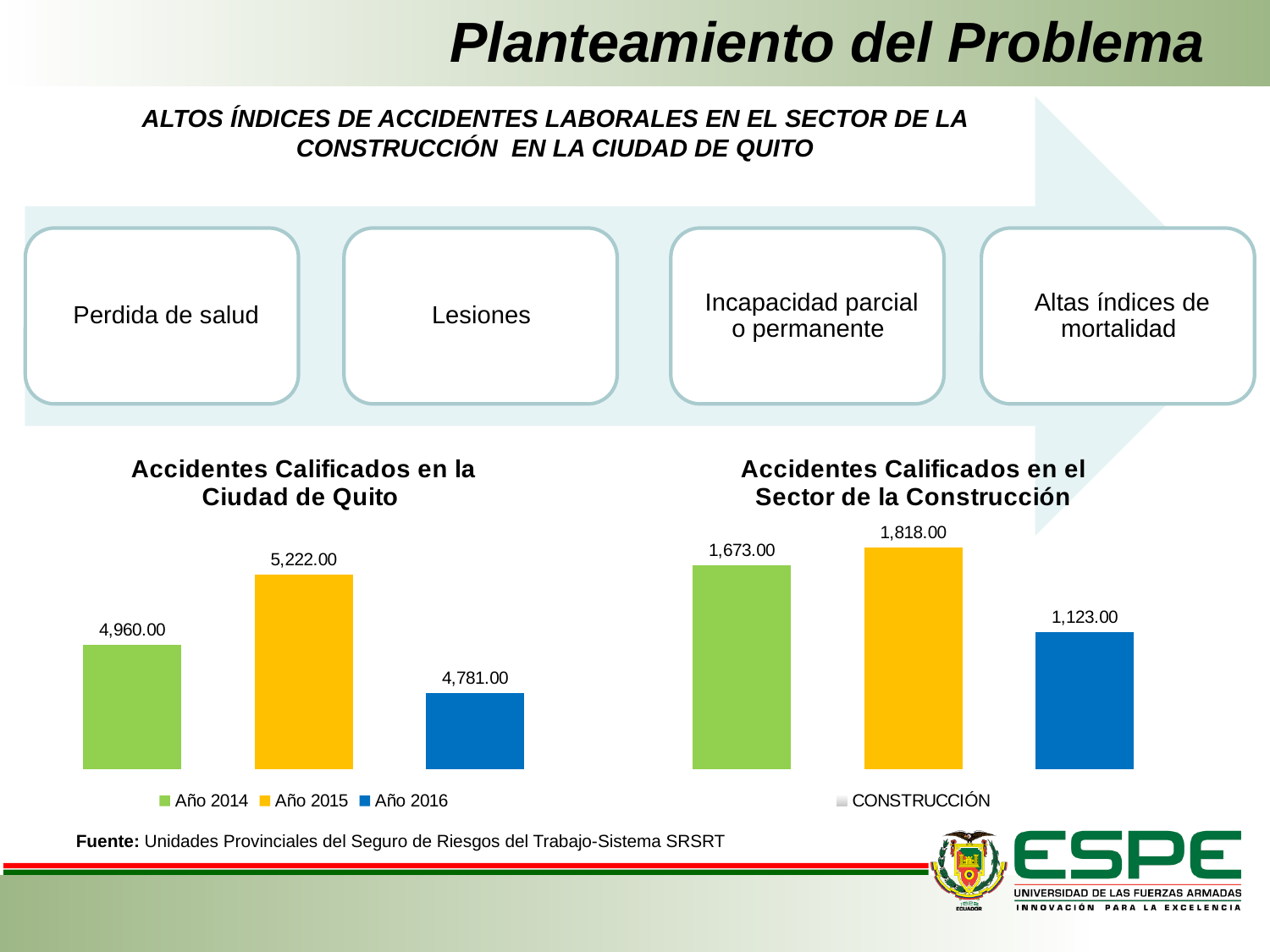
In the chart 'Accidentes Calificados en la Ciudad de Quito', which year has the highest value? Año 2015 In the chart 'Accidentes Calificados en la Ciudad de Quito', how many series does the legend list? 3 In the chart 'Accidentes Calificados en la Ciudad de Quito', what is the value for Año 2016? 4,781.00 In the chart 'Accidentes Calificados en el Sector de la Construcción', what is the value of the tallest bar? 1,818.00 In the chart 'Accidentes Calificados en la Ciudad de Quito', which year has the lowest value? Año 2016 What kind of chart is 'Accidentes Calificados en el Sector de la Construcción'? Bar chart In the chart 'Accidentes Calificados en el Sector de la Construcción', what is the difference between the second bar and the third bar? 695.00 In the chart 'Accidentes Calificados en la Ciudad de Quito', what is the difference between the values for Año 2015 and Año 2014? 262.00 In the chart 'Accidentes Calificados en la Ciudad de Quito', what is the value for Año 2015? 5,222.00 In the chart 'Accidentes Calificados en el Sector de la Construcción', what is the only entry in the legend? CONSTRUCCIÓN In the chart 'Accidentes Calificados en el Sector de la Construcción', what is the value of the first (green) bar? 1,673.00 In the chart 'Accidentes Calificados en el Sector de la Construcción', what is the value of the shortest bar? 1,123.00